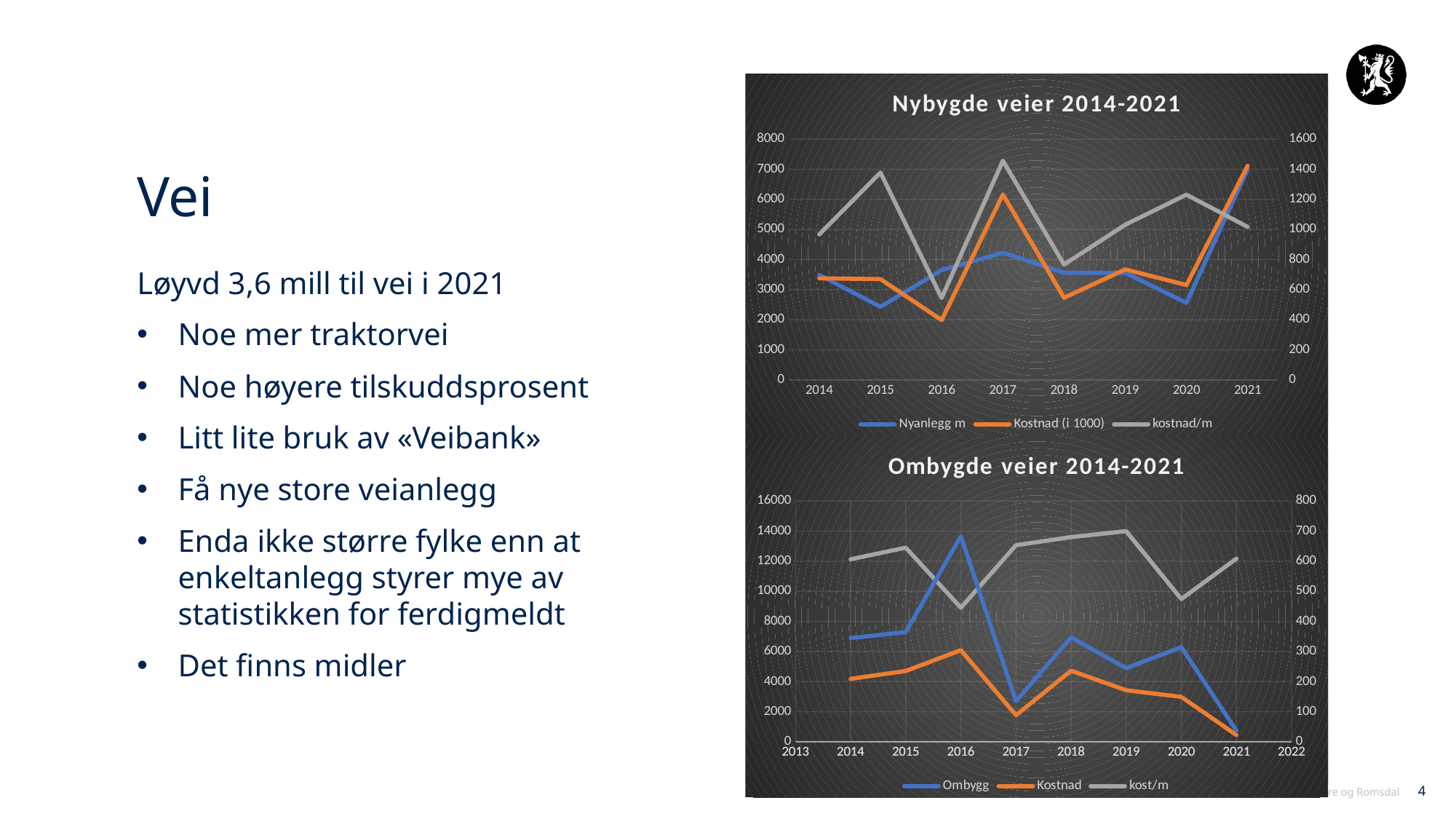
In the 'Nybygde veier 2014-2021' chart, how many years are plotted on the x axis? 8 How many series does the legend of the 'Ombygde veier 2014-2021' chart list? 3 In the 'Ombygde veier 2014-2021' chart, is the Ombygg value for 2016 greater or less than 12000? greater In the 'Nybygde veier 2014-2021' chart, is the Kostnad (i 1000) value for 2017 larger than the value for 2018? Yes, 2017 is larger In the 'Ombygde veier 2014-2021' chart, does the Ombygg series rise or fall from 2020 to 2021? fall In the 'Nybygde veier 2014-2021' chart, which year has the lowest value for Kostnad (i 1000)? 2016 In the 'Nybygde veier 2014-2021' chart, which year has the highest value for Nyanlegg m? 2021 In the 'Nybygde veier 2014-2021' chart, is the Nyanlegg m value for 2021 greater or less than 6000? greater In the 'Ombygde veier 2014-2021' chart, which year has the highest value for Ombygg? 2016 In the 'Ombygde veier 2014-2021' chart, which year has the lowest value for Kostnad? 2021 What kind of chart is the 'Nybygde veier 2014-2021' chart? line chart In the 'Nybygde veier 2014-2021' chart, which series is drawn in grey? kostnad/m